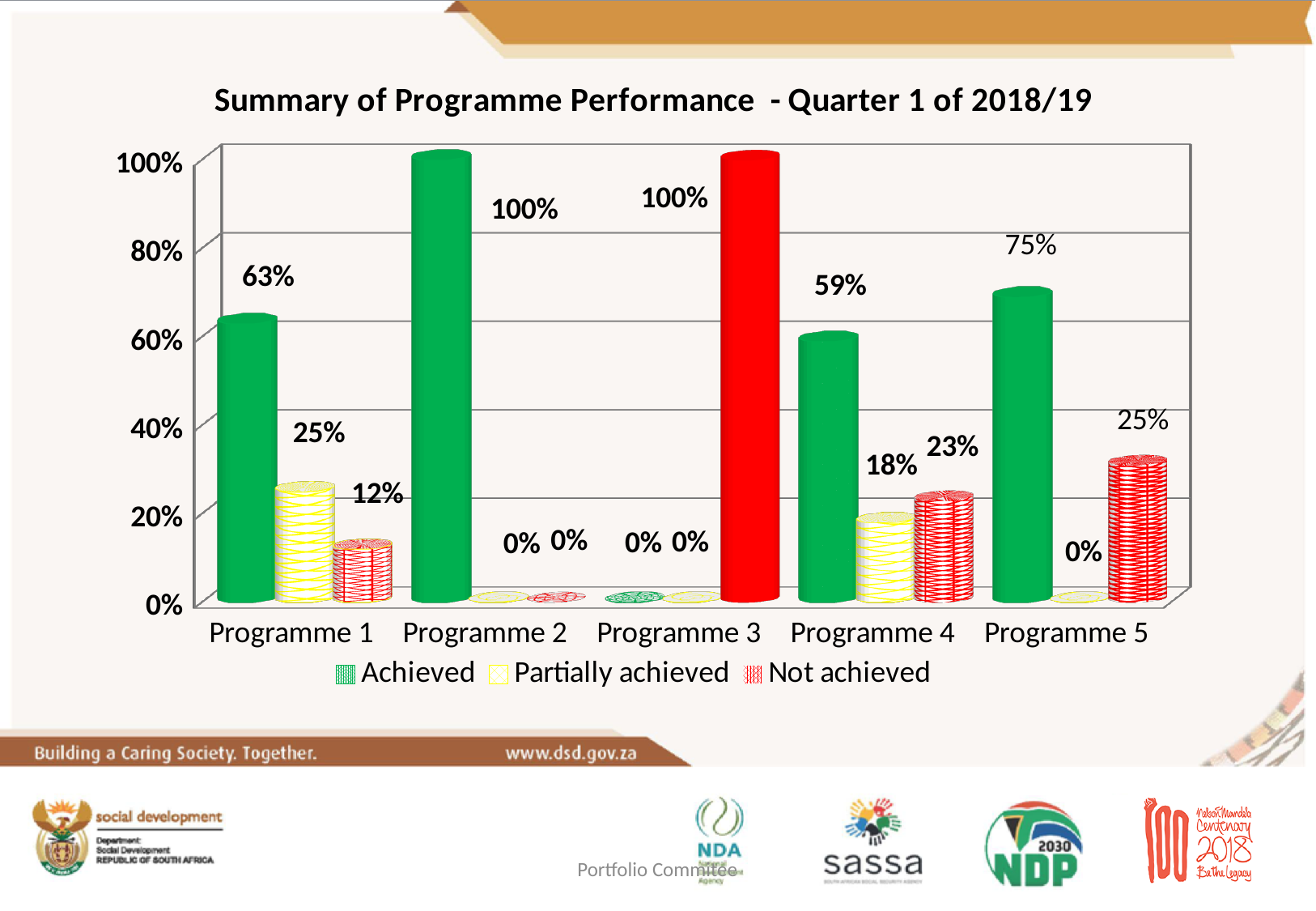
How many programmes are shown on the x axis? 5 What is the Achieved value for Programme 1? 63% What is the Not achieved value for Programme 4? 23% What is the title of the chart? Summary of Programme Performance - Quarter 1 of 2018/19 Which programme has the lowest Achieved value? Programme 3 Which is larger: the Not achieved value for Programme 5 or the Not achieved value for Programme 1? Programme 5 How many series does the legend list? 3 What is the Partially achieved value for Programme 1? 25% What is the difference between the Achieved values for Programme 5 and Programme 4? 16% What is the Not achieved value for Programme 3? 100% Which programme has the highest Achieved value? Programme 2 What kind of chart is shown on the slide? Bar chart